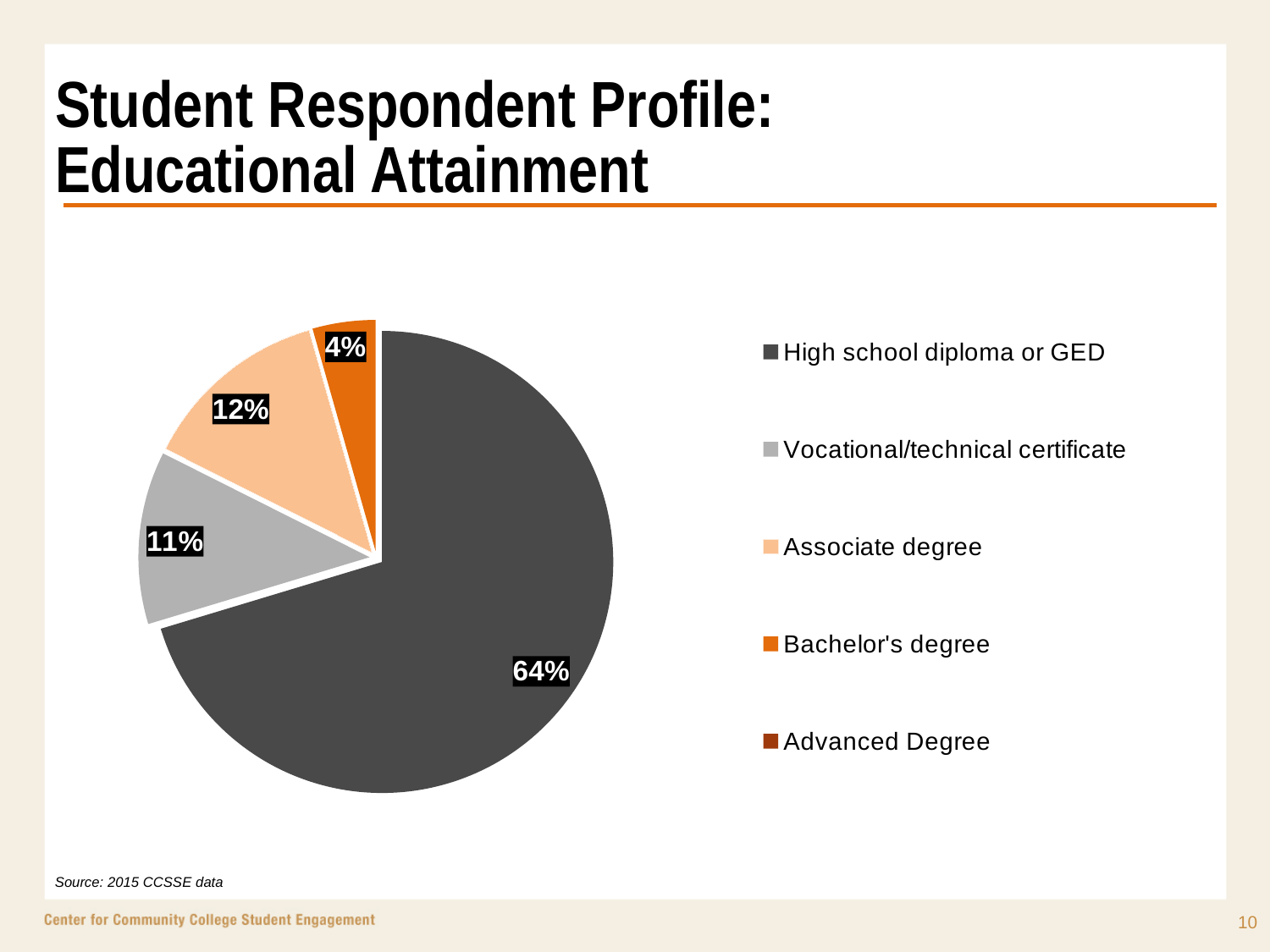
How many categories are listed in the chart's legend? 5 What type of chart is shown on the slide? Pie chart Which is larger: the share for Associate degree or the share for Vocational/technical certificate? Associate degree Among the slices with printed labels, which category has the smallest share? Bachelor's degree What is the difference in percentage points between the Associate degree share and the Vocational/technical certificate share? 1 percentage point What percentage of respondents hold a Vocational/technical certificate? 11% What percentage of respondents hold an Associate degree? 12% How many percentage points larger is the High school diploma or GED share than the Associate degree share? 52 percentage points Which educational attainment category has the largest slice of the pie? High school diploma or GED What colour is the slice representing High school diploma or GED? Dark gray What percentage of respondents have a high school diploma or GED as their highest educational attainment? 64% What percentage of respondents hold a Bachelor's degree? 4%